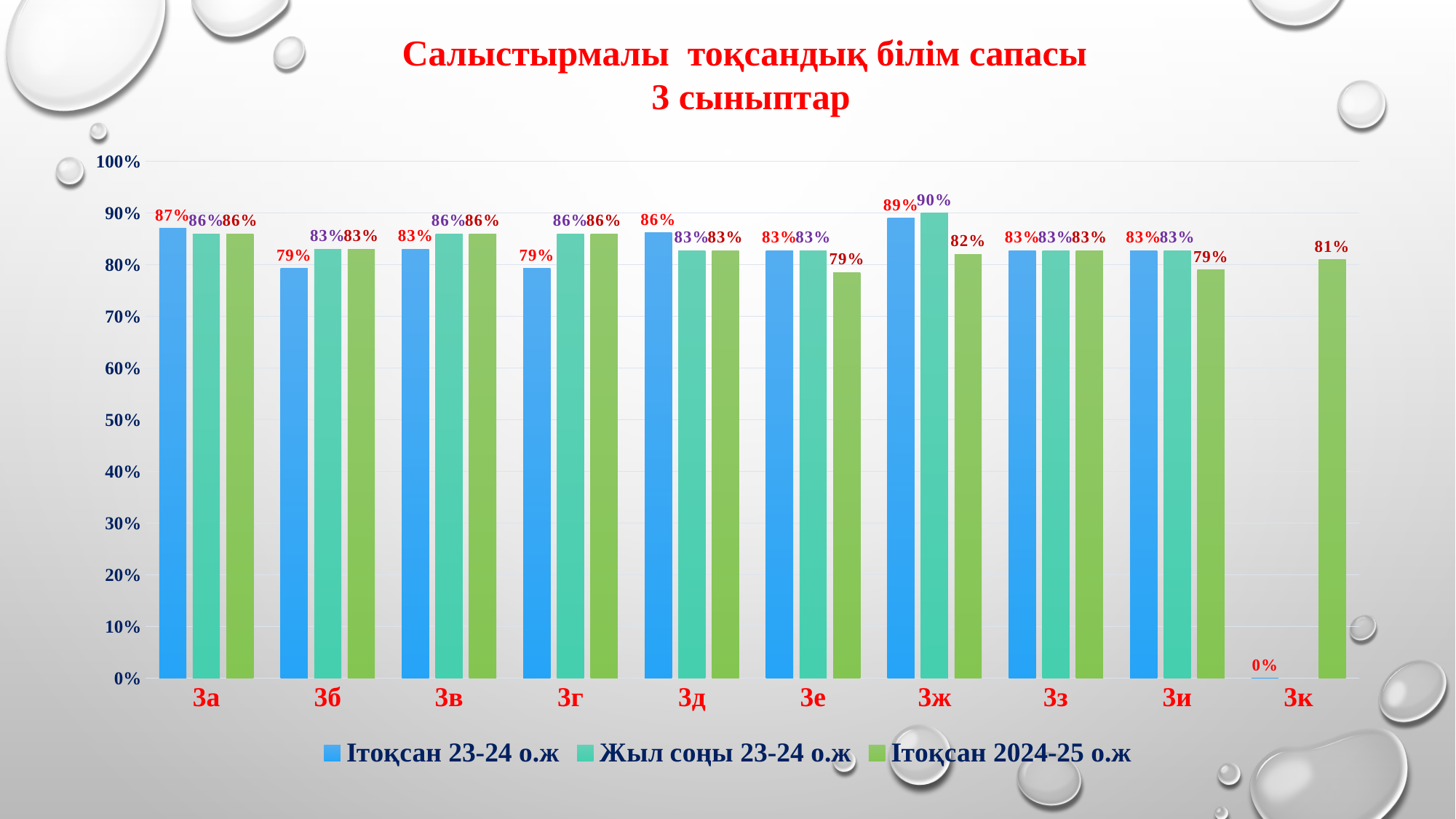
For 3ж, what is the difference between the Жыл соңы 23-24 о.ж value and the Ітоқсан 2024-25 о.ж value? 8% Is the value for 3ж in the Ітоқсан 2024-25 о.ж series greater or less than 90%? less What is the value for 3д in the Ітоқсан 23-24 о.ж series? 86% How many series does the legend list? 3 Which class has the highest value in the Ітоқсан 23-24 о.ж series? 3ж What colour represents the Ітоқсан 2024-25 о.ж series in the legend? green What is the value for 3к in the Ітоқсан 2024-25 о.ж series? 81% Which class has the highest value in the Жыл соңы 23-24 о.ж series? 3ж For 3б, which is larger: the Ітоқсан 23-24 о.ж value or the Жыл соңы 23-24 о.ж value? Жыл соңы 23-24 о.ж How many classes (categories) are shown on the x axis? 10 What kind of chart is shown on the slide? bar chart What is the value for 3ж in the Ітоқсан 23-24 о.ж series? 89%